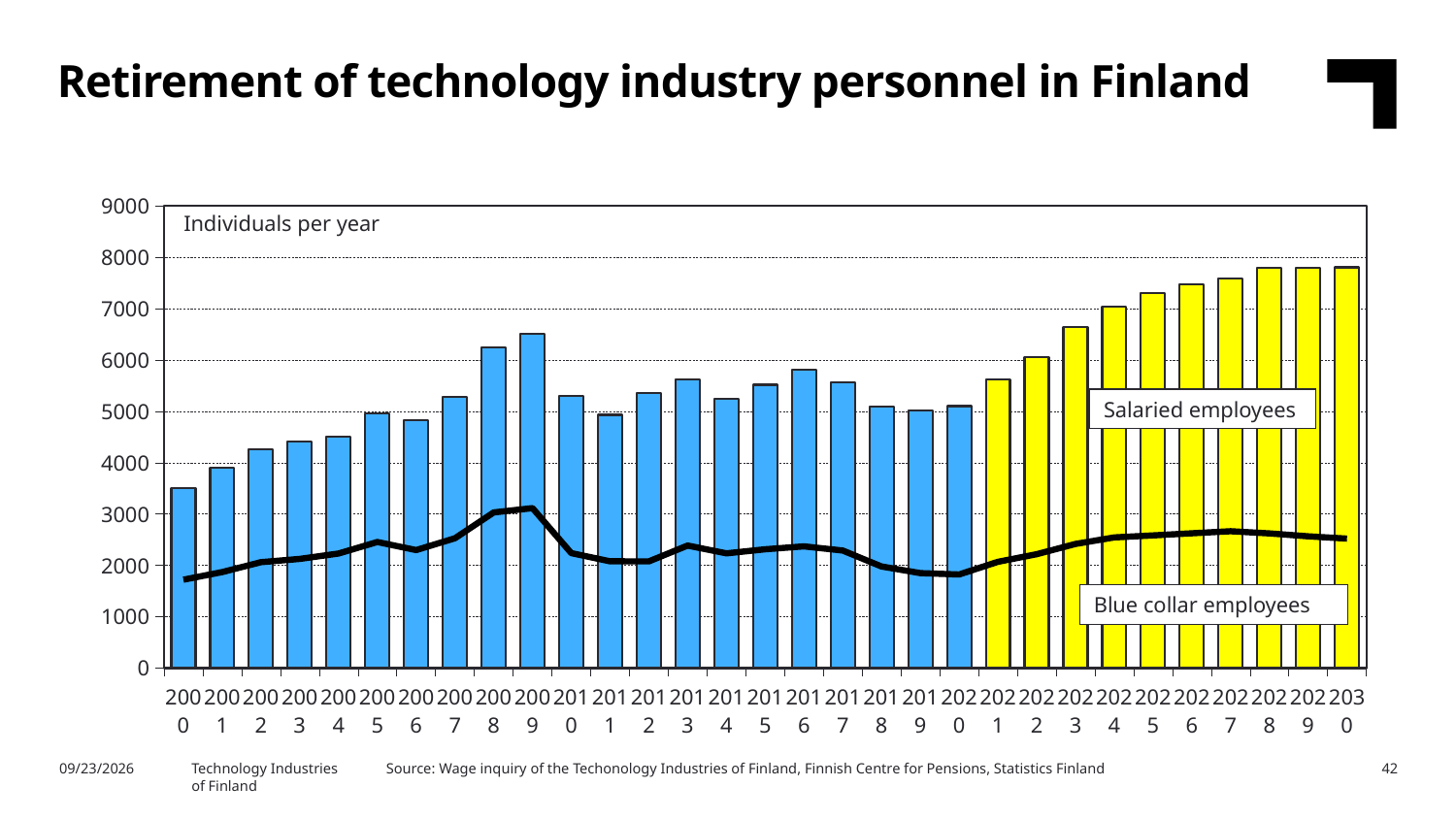
Which year has the larger bar, 2009 or 2010? 2009 Among the blue bars (2000 to 2020), which year has the highest bar? 2009 Which year has the lowest bar in the chart? 2000 Is the bar value for 2030 greater or less than 7000? greater What kind of chart is shown on the slide? Bar chart with a line How many years are shown along the x axis of the chart? 31 Do the bar values rise or fall from 2021 to 2030? Rise Is the black line value for 2000 greater or less than 2000? less What unit label is printed inside the plot area of the chart? Individuals per year Is the bar value for 2000 greater or less than 4000? less What colour are the bars for the years 2021 to 2030? Yellow